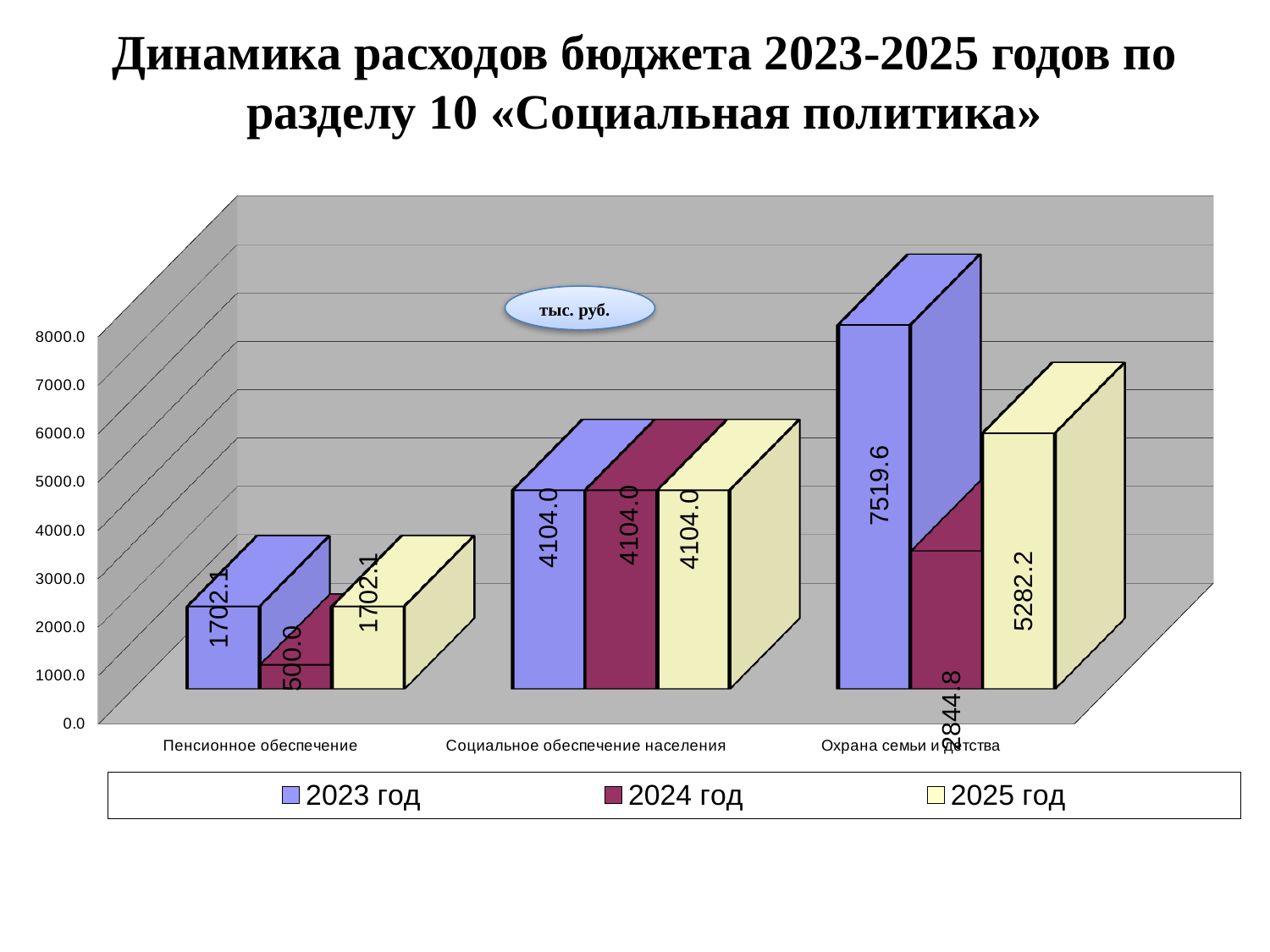
What is the difference between the 2023 год and 2025 год values for Охрана семьи и детства? 2237.4 What is the value for Охрана семьи и детства in 2025 год? 5282.2 How many categories are shown on the x axis? 3 Which is larger: the 2024 год value for Охрана семьи и детства or the 2024 год value for Социальное обеспечение населения? Социальное обеспечение населения What is the value for Пенсионное обеспечение in 2024 год? 500.0 What kind of chart is shown on the slide? Bar chart How many series does the legend list? 3 Which category has the highest value in the 2023 год series? Охрана семьи и детства What is the difference between the 2023 год and 2024 год values for Пенсионное обеспечение? 1202.1 Which category has the lowest value in the 2024 год series? Пенсионное обеспечение What is the value for Социальное обеспечение населения in 2025 год? 4104.0 What is the value for Охрана семьи и детства in 2023 год? 7519.6